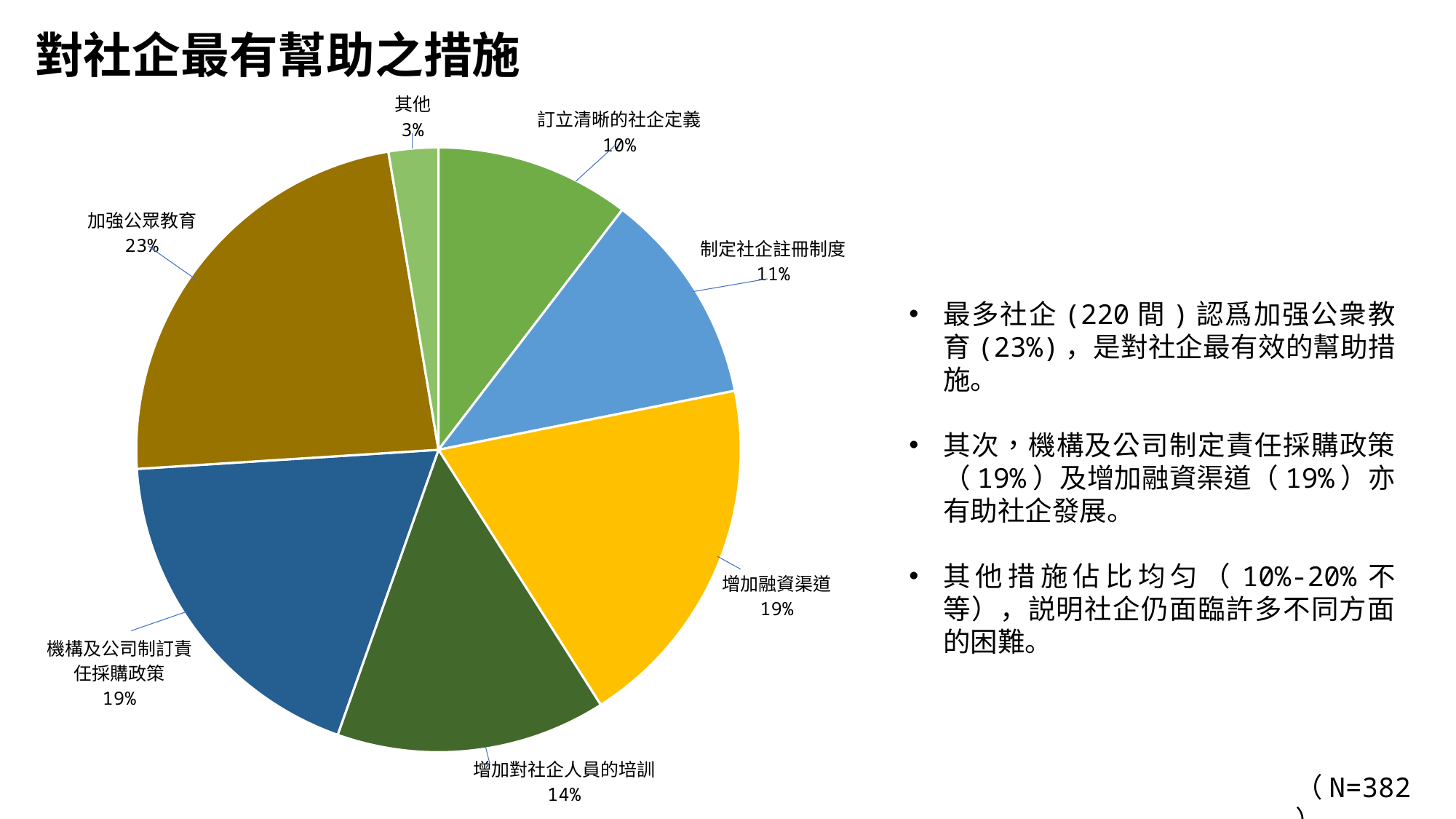
What is the title of the slide containing the pie chart? 對社企最有幫助之措施 What share of the pie does 訂立清晰的社企定義 have? 10% What share of the pie does 增加對社企人員的培訓 have? 14% What share of the pie does 加強公眾教育 have? 23% What kind of chart is shown on the slide? pie chart What is the difference in percentage points between 加強公眾教育 and 增加融資渠道? 4% Which category has the largest slice of the pie? 加強公眾教育 What colour is the slice for 增加融資渠道? yellow How many slices does the pie chart have? 7 Which is larger, the slice for 增加對社企人員的培訓 or the slice for 制定社企註冊制度? 增加對社企人員的培訓 Which category has the smallest slice of the pie? 其他